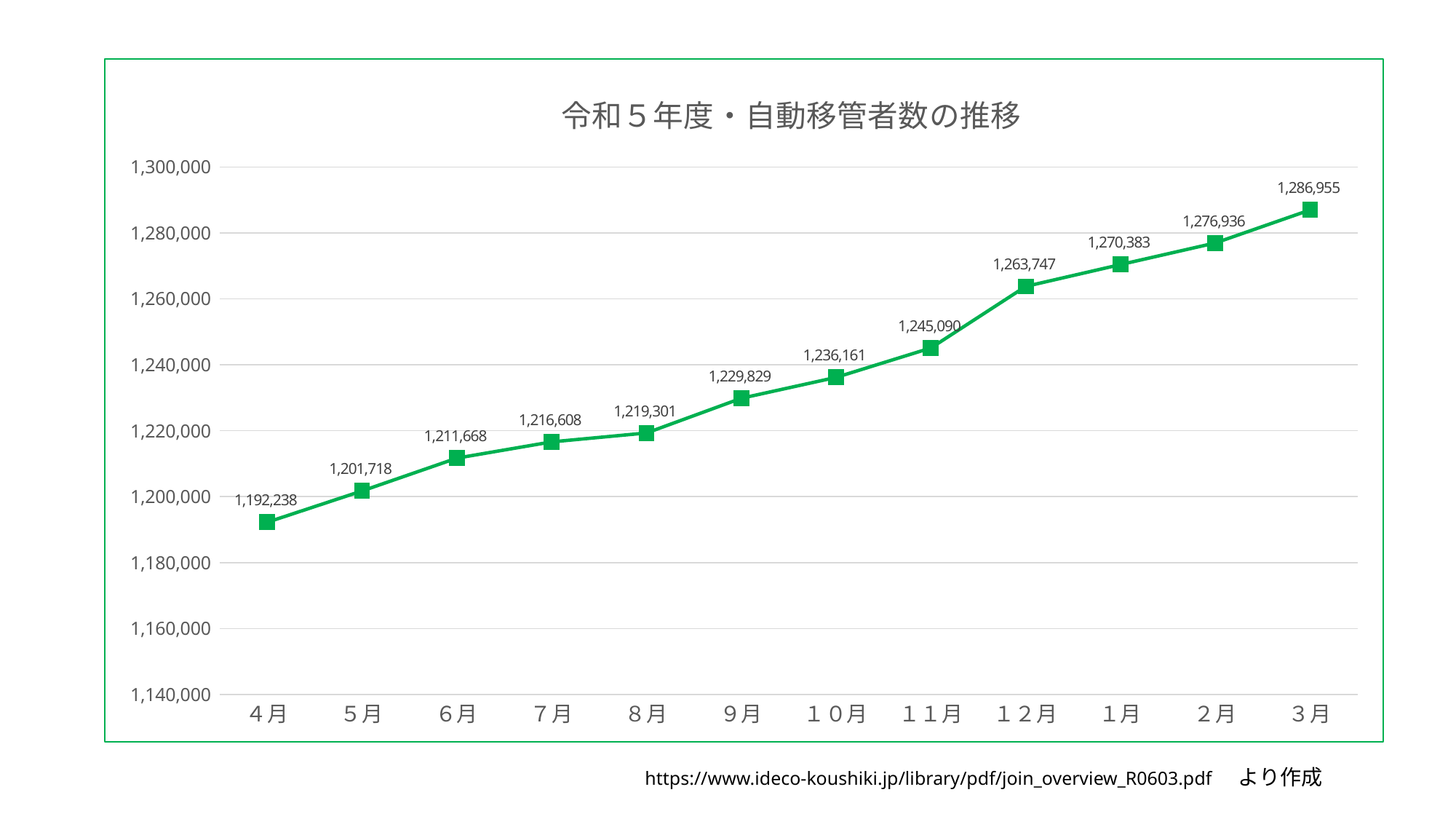
What is the difference between the values for 3月 and 4月? 94,717 How many months are plotted in the chart? 12 What kind of chart is shown on the slide? line chart Which is larger, the value for 7月 or the value for 10月? 10月 What is the value for 4月 in the chart? 1,192,238 What is the value for 9月 in the chart? 1,229,829 Is the value for 1月 greater or less than 1,260,000? greater What is the difference between the values for 12月 and 11月? 18,657 Do the values rise or fall from 4月 to 3月? rise What is the value for 12月 in the chart? 1,263,747 Which month has the highest value in the chart? 3月 Which month has the lowest value in the chart? 4月